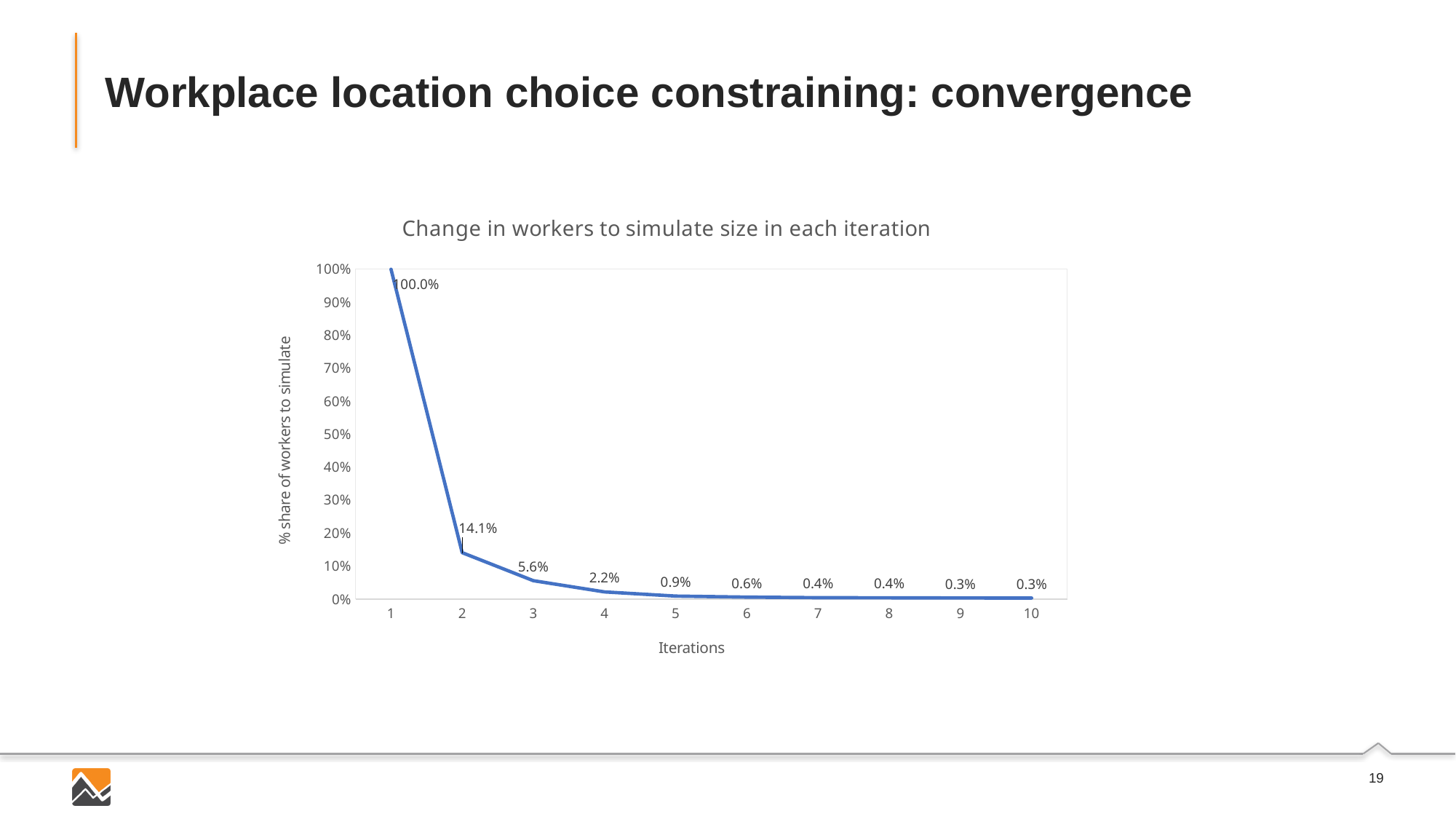
How many iterations are plotted on the x axis? 10 What is the value at iteration 5? 0.9% What is the difference between the values at iteration 1 and iteration 2? 85.9% Which iteration has the highest value? 1 What is the title of the chart? Change in workers to simulate size in each iteration What is the difference between the values at iteration 2 and iteration 3? 8.5% Which is larger, the value at iteration 4 or the value at iteration 6? iteration 4 What is the value at iteration 3? 5.6% What is the value at iteration 2? 14.1% What kind of chart is shown? line chart Do the values rise or fall as the iterations increase? fall What is the value at iteration 10? 0.3%